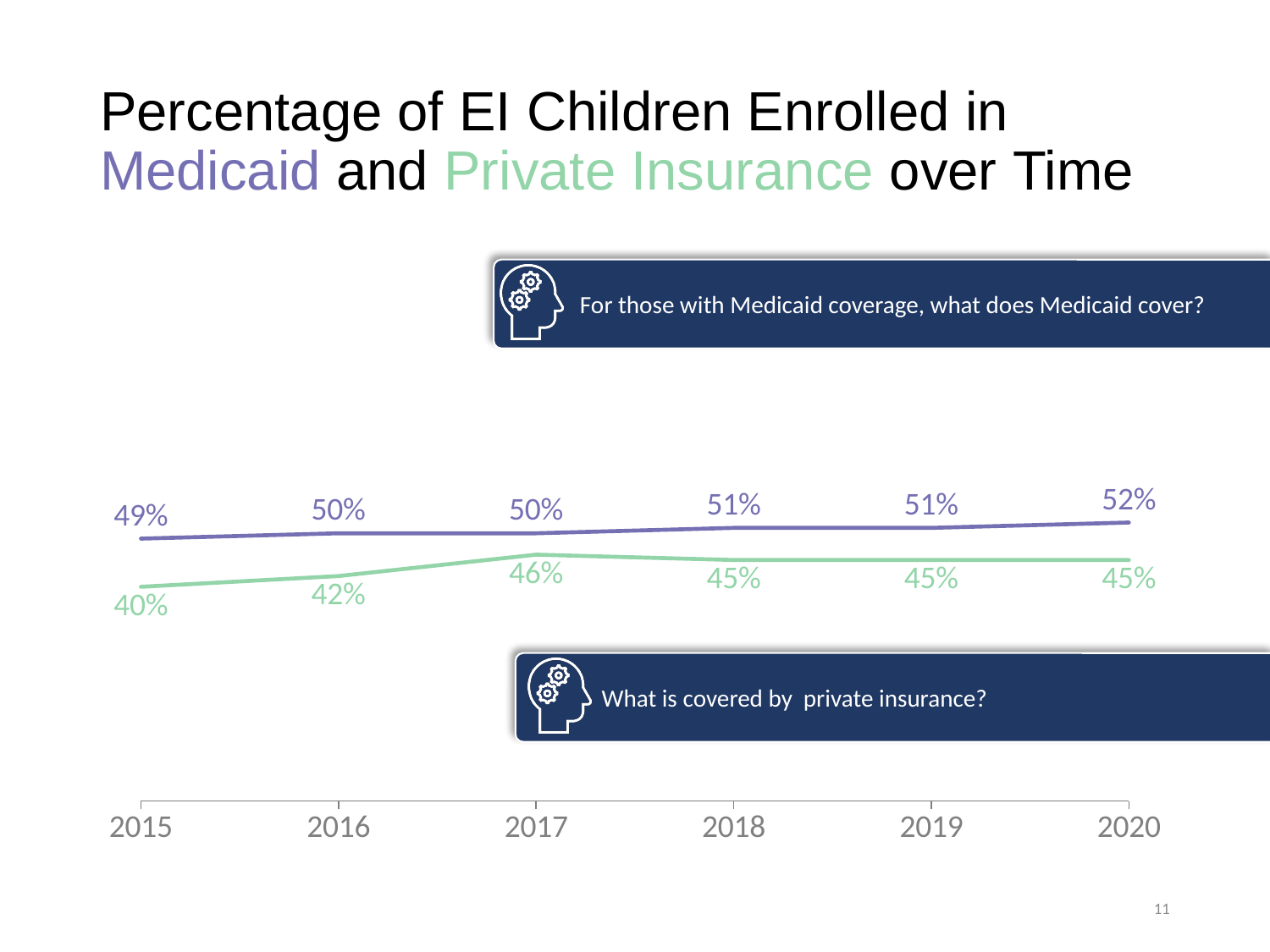
What percentage of EI children were enrolled in Private Insurance in 2017? 46% How many data series are plotted on the chart? 2 In which year is the Private Insurance percentage lowest? 2015 Does the Medicaid percentage rise or fall from 2015 to 2020? Rise By how much did the Private Insurance percentage change from 2015 to 2020? 5% What is the difference between the Medicaid and Private Insurance percentages in 2015? 9% How many years are shown on the x axis? 6 What kind of chart is shown on the slide? Line chart What percentage of EI children were enrolled in Medicaid in 2015? 49% Which is larger in 2018, the Medicaid percentage or the Private Insurance percentage? Medicaid What is the Medicaid value for 2020? 52% In which year is the Medicaid percentage highest? 2020